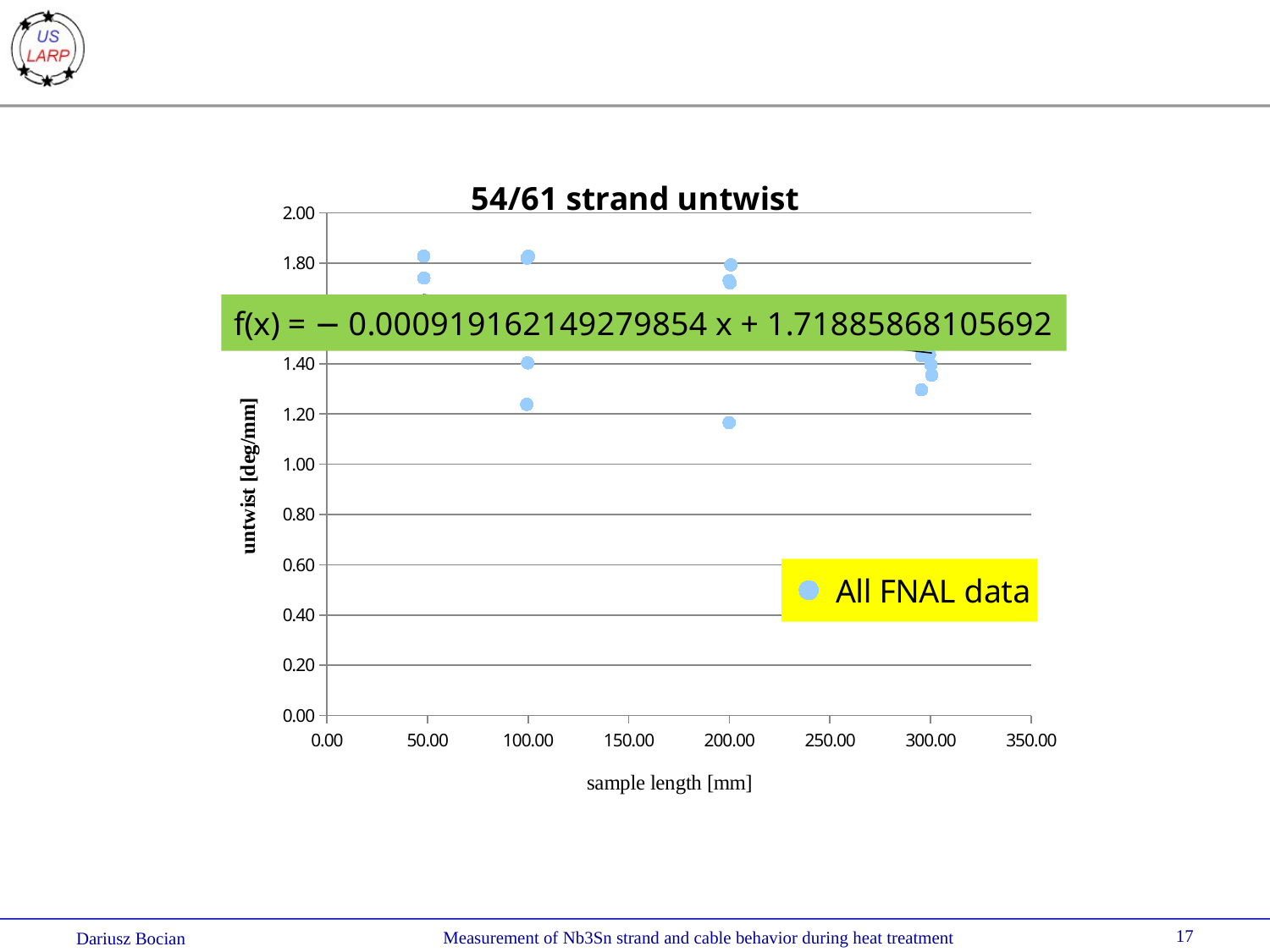
What is the name of the series shown in the legend? All FNAL data According to the fitted trendline equation, do the untwist values rise or fall as sample length increases? fall Is the lowest untwist value at a sample length of 100.00 mm greater or less than 1.00? greater What is the title of the chart? 54/61 strand untwist What is the slope coefficient in the trendline equation f(x) shown on the chart? −0.000919162149279854 Are the untwist values at a sample length of about 300.00 mm greater or less than 1.60? less What is the maximum value shown on the y axis of the chart? 2.00 How many data series does the legend list? 1 What is the intercept term in the trendline equation f(x) shown on the chart? 1.71885868105692 Is the highest untwist value at a sample length of 50.00 mm greater or less than 1.60? greater What kind of chart is shown on the slide? scatter chart